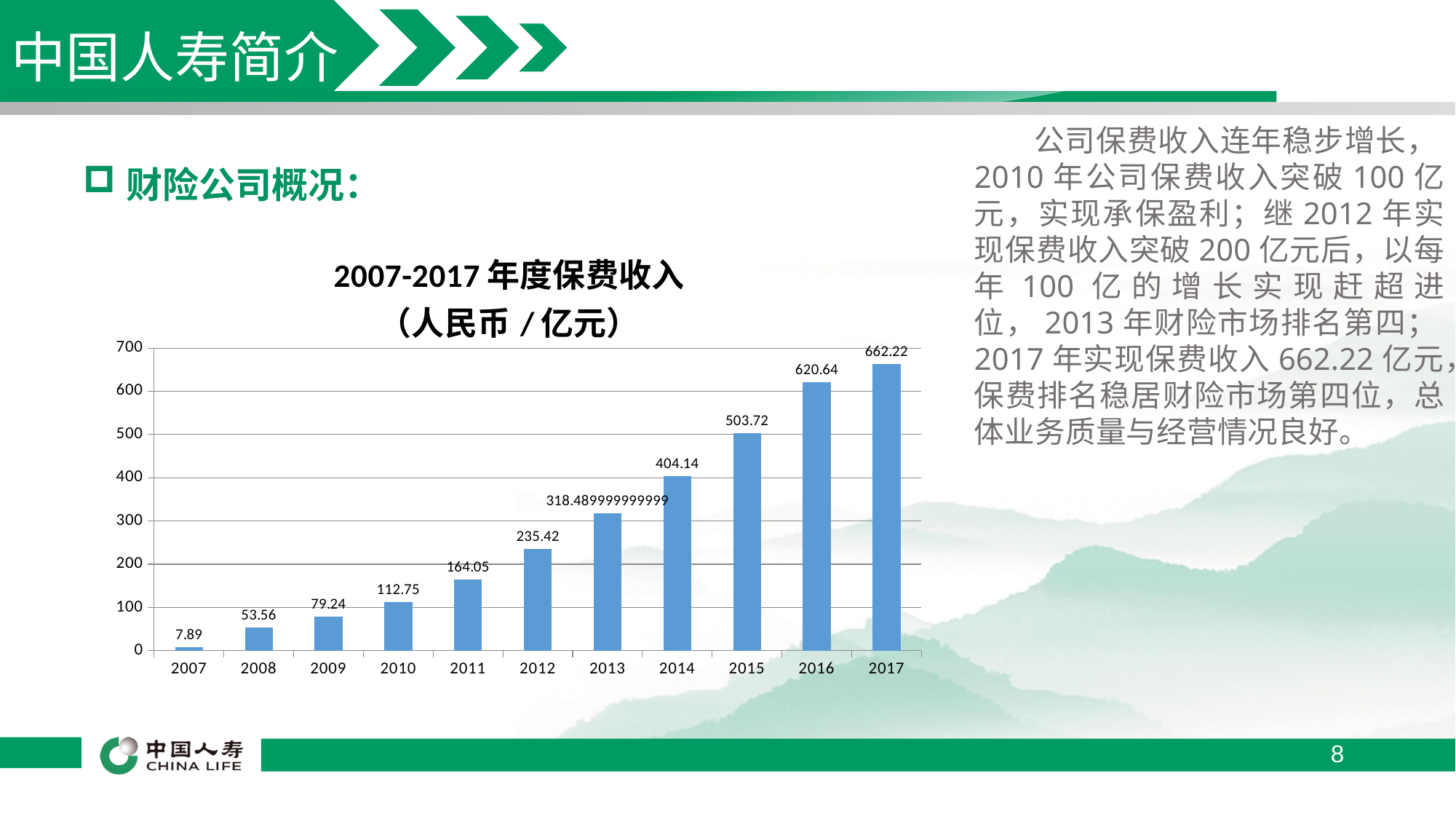
What is the value for 2010? 112.75 Is the value for 2015 greater or less than 500? greater Do the values rise or fall from 2007 to 2017? rise Which year has the lowest value? 2007 What is the value for 2017? 662.22 How many years are shown on the x axis? 11 Which year has the highest value? 2017 Which is larger, the value for 2012 or the value for 2011? 2012 What is the value for 2014? 404.14 What is the value for 2007? 7.89 What is the difference between the values for 2017 and 2016? 41.58 What kind of chart is this? bar chart